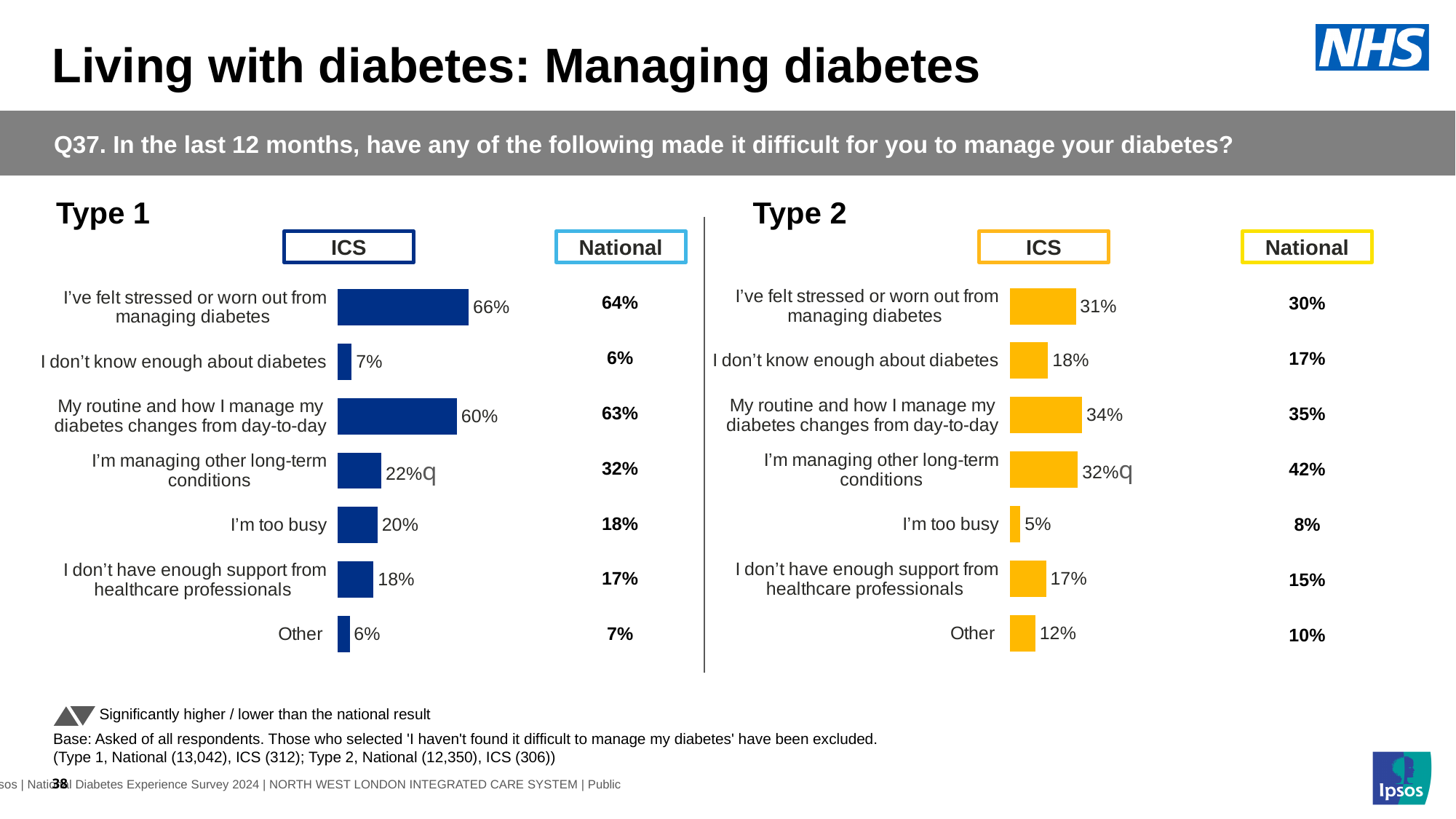
In the Type 1 chart, what is the difference between the ICS and National values for 'I'm managing other long-term conditions'? 10 percentage points How many categories are shown in the Type 1 chart? 7 What colour are the bars in the Type 2 chart? Yellow In the Type 2 chart, which is larger: the ICS value for 'My routine and how I manage my diabetes changes from day-to-day' or the ICS value for 'I've felt stressed or worn out from managing diabetes'? My routine and how I manage my diabetes changes from day-to-day In the Type 1 chart, is the ICS value for 'I'm too busy' larger or smaller than the ICS value for 'I don't have enough support from healthcare professionals'? larger In the Type 2 chart, what is the ICS value for 'I'm managing other long-term conditions'? 32% In the Type 1 chart, what is the ICS value for 'I've felt stressed or worn out from managing diabetes'? 66% In the Type 2 chart, what is the National value for 'I'm too busy'? 8% In the Type 2 chart, what is the difference between the ICS and National values for 'I'm managing other long-term conditions'? 10 percentage points In the Type 1 chart, which category has the highest ICS value? I've felt stressed or worn out from managing diabetes What type of chart is used for the Type 2 ICS results? Bar chart In the Type 2 chart, which category has the lowest ICS value? I'm too busy